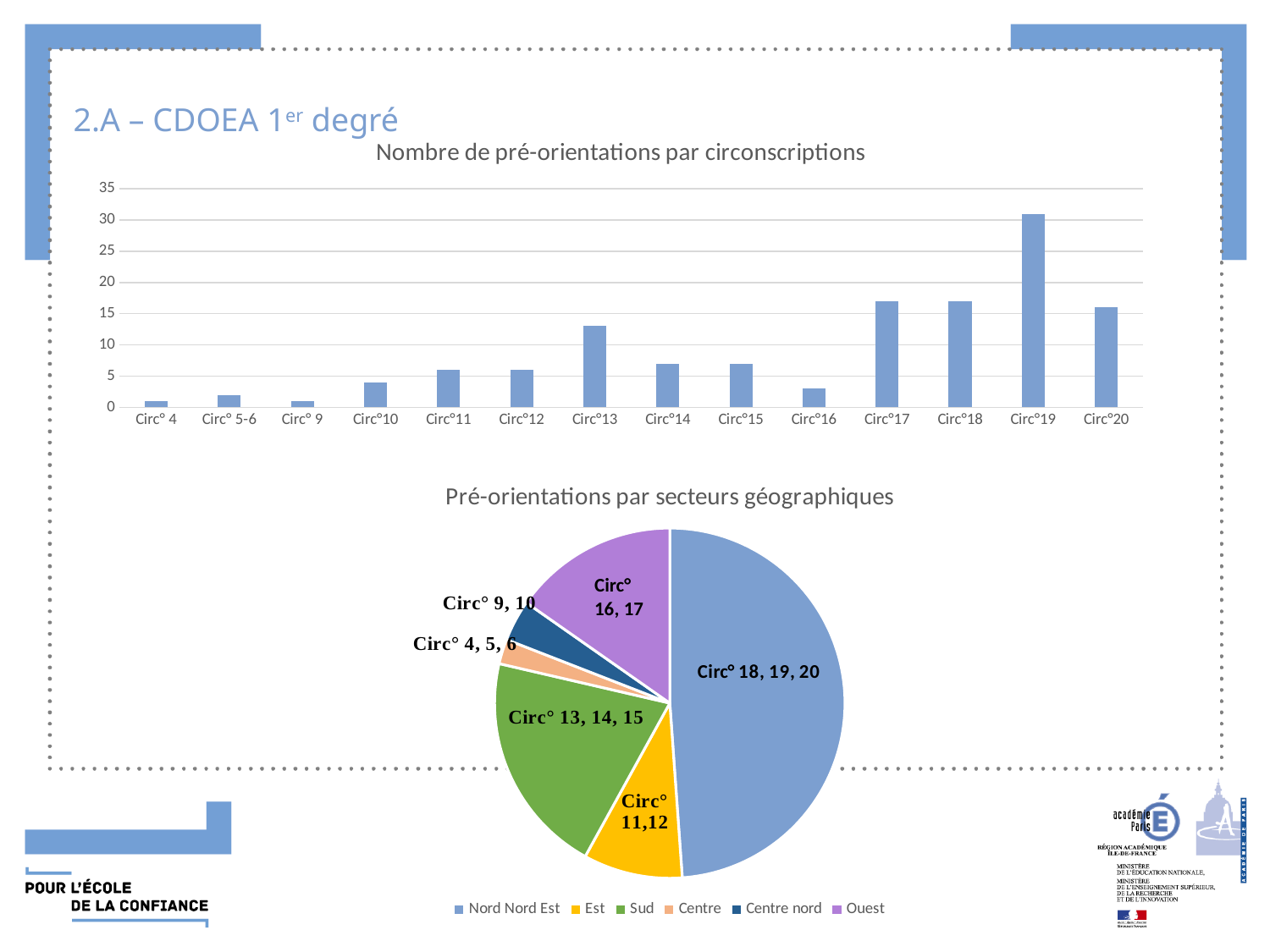
On the chart titled 'Nombre de pré-orientations par circonscriptions', is the value for Circ°19 greater or less than 25? greater On the chart titled 'Nombre de pré-orientations par circonscriptions', is the value for Circ°10 greater or less than 5? less How many circonscriptions are shown on the x axis of the chart titled 'Nombre de pré-orientations par circonscriptions'? 14 On the chart titled 'Nombre de pré-orientations par circonscriptions', which circonscription has the highest value? Circ°19 What kind of chart is the top chart titled 'Nombre de pré-orientations par circonscriptions'? bar chart On the chart titled 'Pré-orientations par secteurs géographiques', which is larger, the Sud slice or the Est slice? Sud On the chart titled 'Nombre de pré-orientations par circonscriptions', which is larger, the value for Circ°17 or the value for Circ°14? Circ°17 How many entries does the legend of the chart titled 'Pré-orientations par secteurs géographiques' list? 6 On the chart titled 'Pré-orientations par secteurs géographiques', which slice is the largest? Circ° 18, 19, 20 What kind of chart is the bottom chart titled 'Pré-orientations par secteurs géographiques'? pie chart On the chart titled 'Nombre de pré-orientations par circonscriptions', is the value for Circ°16 greater or less than 5? less